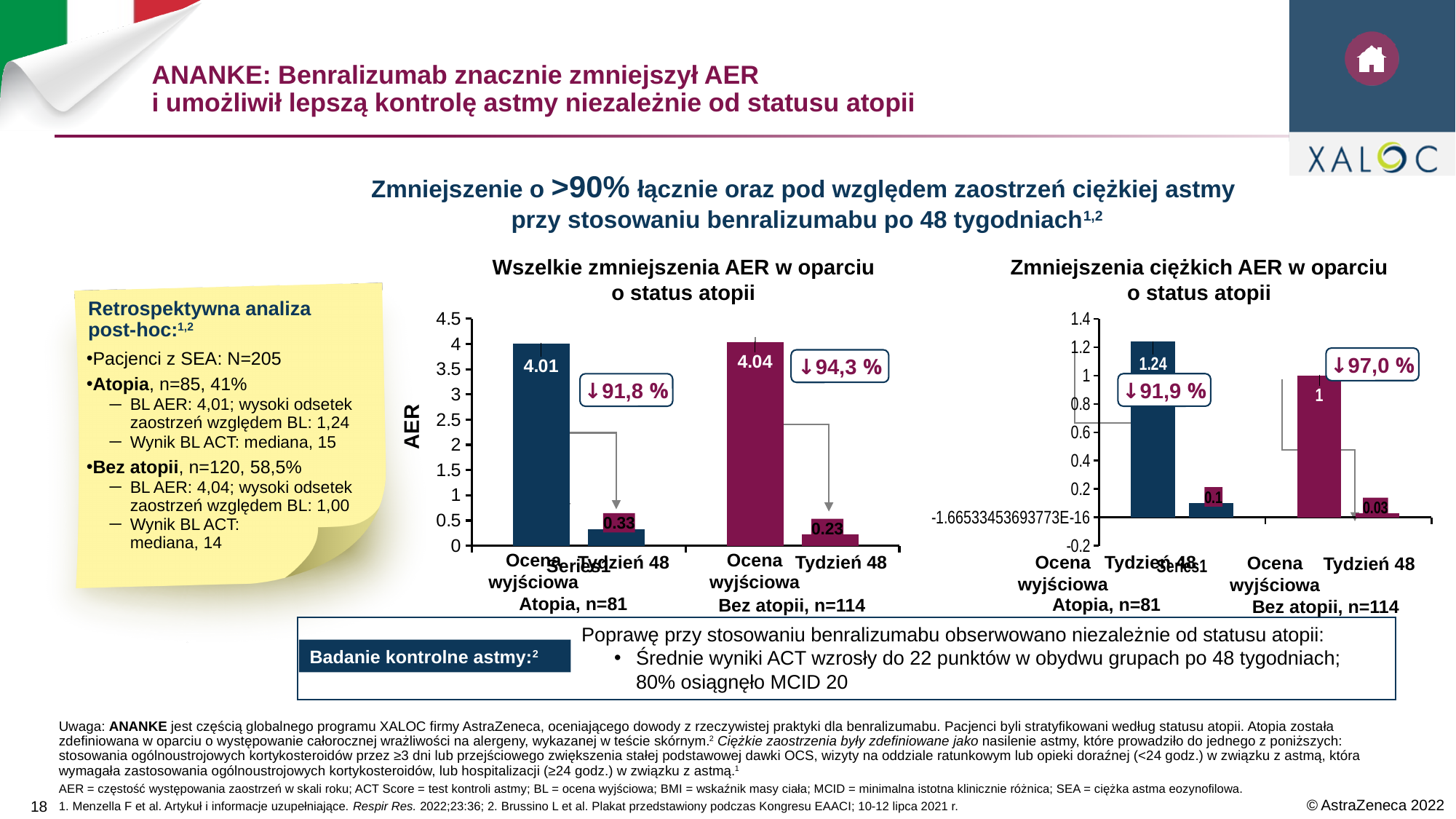
In the chart titled "Zmniejszenia ciężkich AER w oparciu o status atopii", is the baseline value for the Atopia, n=81 group greater or less than the baseline value for the Bez atopii, n=114 group? greater In the chart titled "Wszelkie zmniejszenia AER w oparciu o status atopii", what is the baseline (Ocena wyjściowa) AER value for the Atopia, n=81 group? 4.01 In the chart titled "Zmniejszenia ciężkich AER w oparciu o status atopii", what percentage reduction is shown for the Bez atopii, n=114 group? 97,0 % What type of chart is the chart titled "Wszelkie zmniejszenia AER w oparciu o status atopii"? Bar chart In the chart titled "Wszelkie zmniejszenia AER w oparciu o status atopii", what is the AER value at Tydzień 48 for the Atopia, n=81 group? 0.33 In the chart titled "Zmniejszenia ciężkich AER w oparciu o status atopii", which bar has the lowest value? Tydzień 48, Bez atopii, n=114 (0.03) In the chart titled "Wszelkie zmniejszenia AER w oparciu o status atopii", what is the difference between the baseline and Tydzień 48 values for the Atopia, n=81 group? 3.68 In the chart titled "Wszelkie zmniejszenia AER w oparciu o status atopii", what is the AER value at Tydzień 48 for the Bez atopii, n=114 group? 0.23 In the chart titled "Zmniejszenia ciężkich AER w oparciu o status atopii", what is the value at Tydzień 48 for the Bez atopii, n=114 group? 0.03 In the chart titled "Wszelkie zmniejszenia AER w oparciu o status atopii", what percentage reduction is shown for the Bez atopii, n=114 group? 94,3 % In the chart titled "Zmniejszenia ciężkich AER w oparciu o status atopii", what is the baseline (Ocena wyjściowa) value for the Atopia, n=81 group? 1.24 In the chart titled "Wszelkie zmniejszenia AER w oparciu o status atopii", which bar has the highest value? Ocena wyjściowa, Bez atopii, n=114 (4.04)